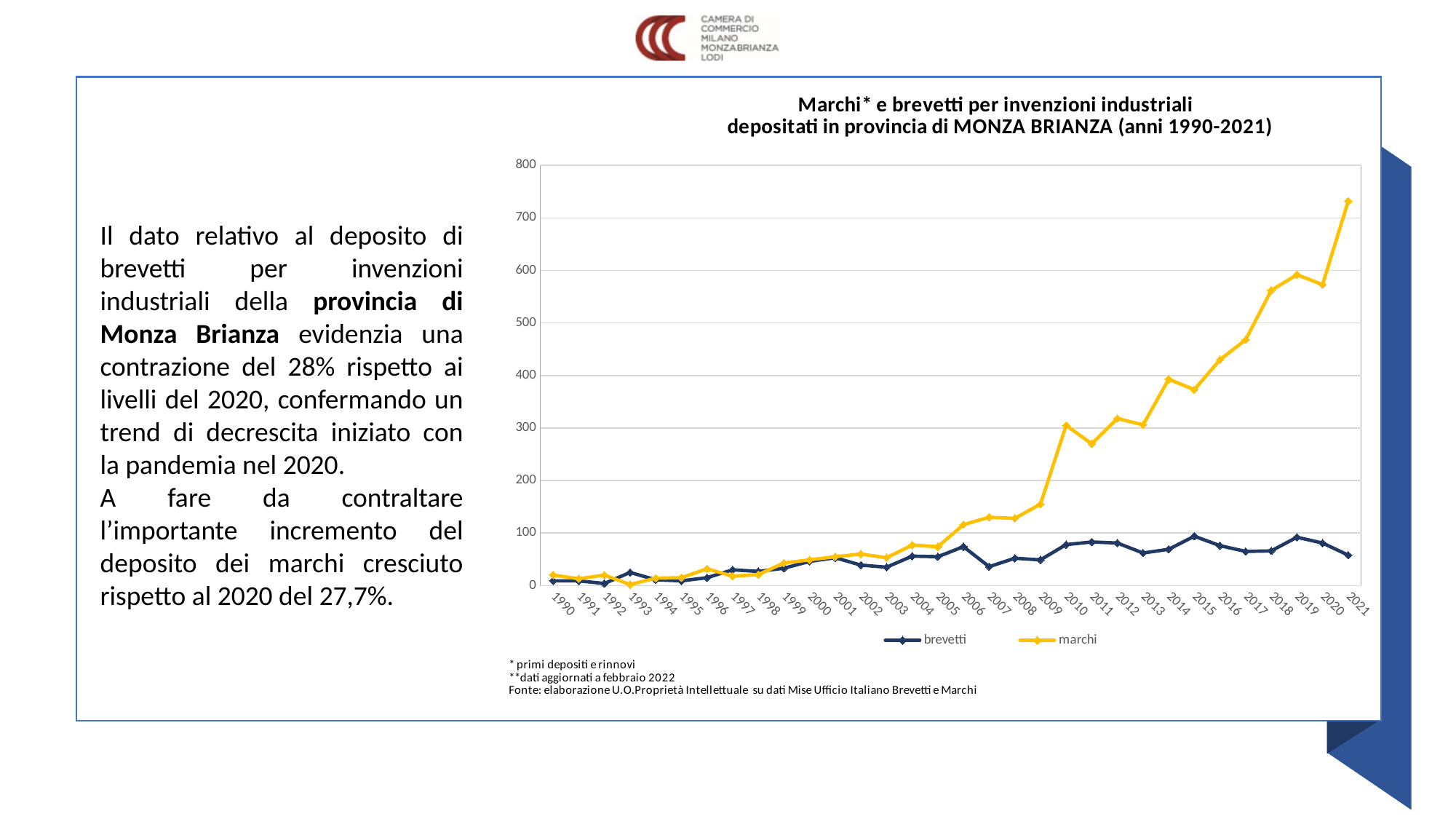
How many series does the legend list? 2 How many years are plotted along the x axis? 32 Which series has the larger value in 1993, brevetti or marchi? brevetti Which series has the larger value in 2021, brevetti or marchi? marchi In which year does the marchi series reach its lowest value? 1993 Is the value for marchi in 2018 greater or less than 500? greater In which year does the marchi series reach its highest value? 2021 What kind of chart is shown on the slide? line chart Does the marchi series overall rise or fall from 1990 to 2021? rise Is the value for marchi in 2021 greater or less than 700? greater What are the two series named in the legend? brevetti and marchi